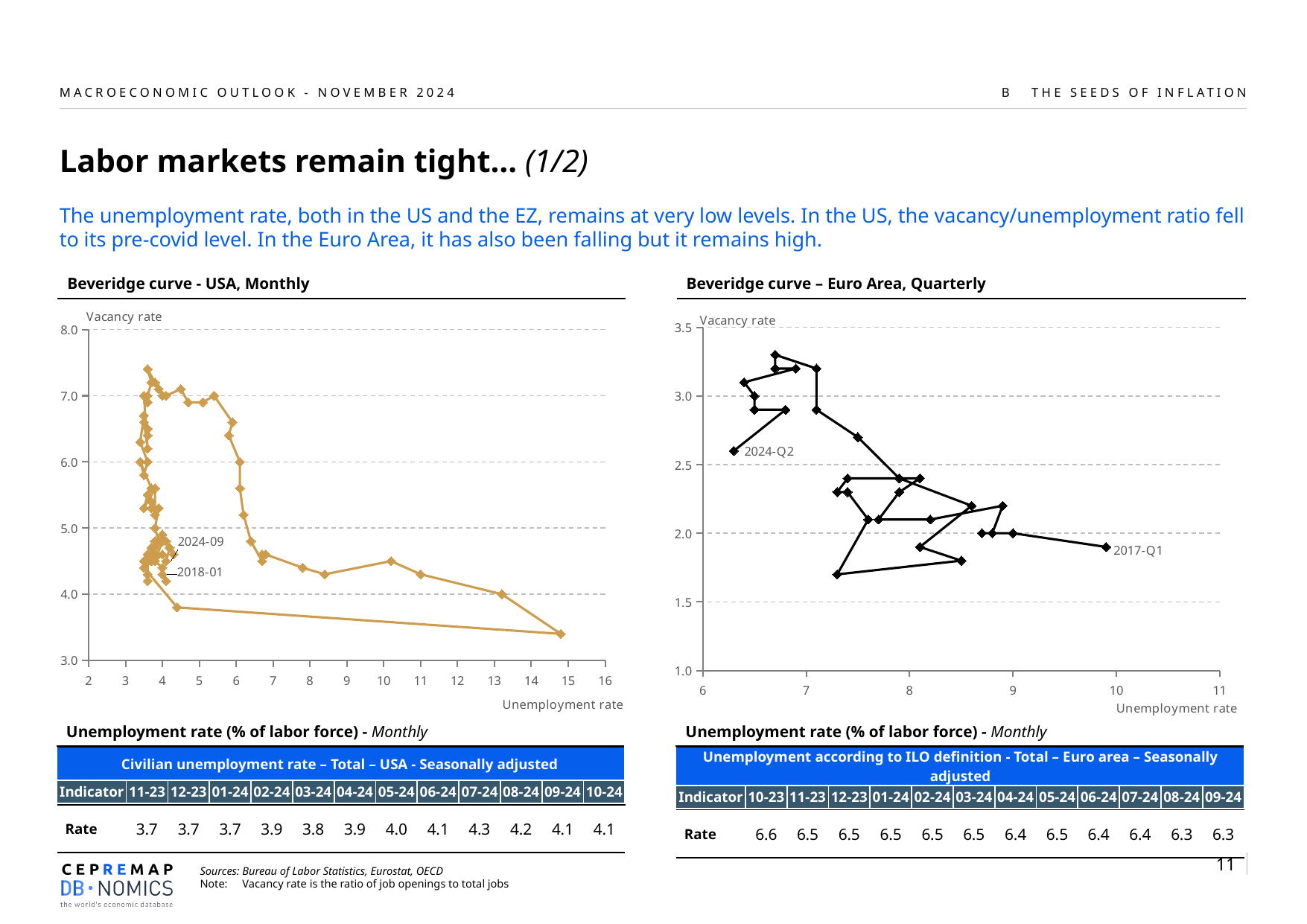
In the Beveridge curve – Euro Area, Quarterly chart, is the unemployment rate at the point labelled 2017-Q1 greater or less than 9? greater What kind of chart is the Beveridge curve - USA, Monthly chart? line chart (connected scatter plot) In the Beveridge curve – Euro Area, Quarterly chart, what variable is plotted on the horizontal axis? Unemployment rate In the Beveridge curve - USA, Monthly chart, is the vacancy rate at the point labelled 2018-01 greater or less than 5.0? less In the Beveridge curve – Euro Area, Quarterly chart, is the unemployment rate at the point labelled 2024-Q2 greater or less than 7? less What is the title of the chart on the left of the slide? Beveridge curve - USA, Monthly